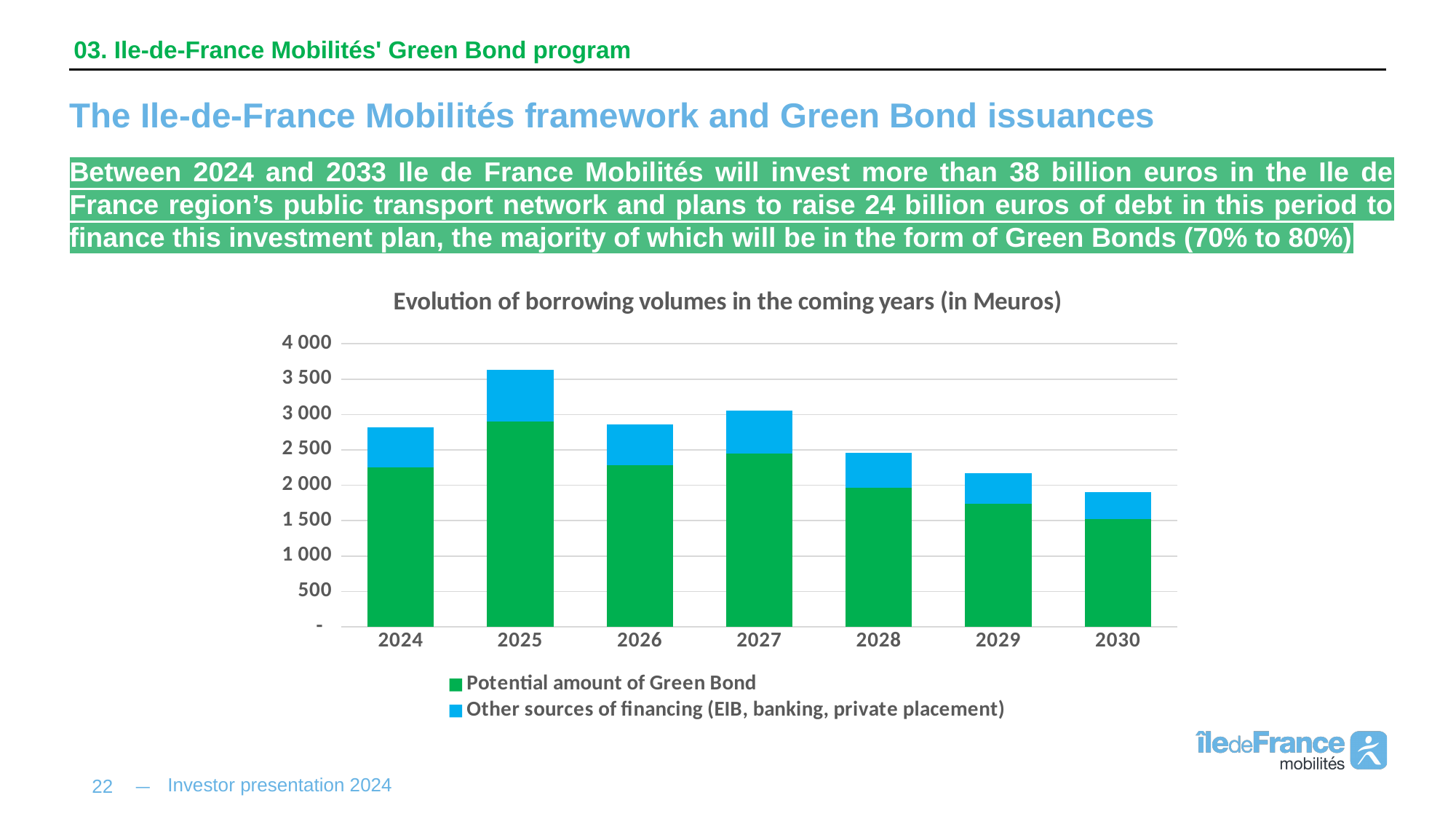
Is the potential amount of Green Bond for 2024 greater or less than 2 000? greater How many years are shown on the x axis of the chart? 7 From 2027 to 2030, do the total borrowing volumes rise or fall? Fall How many series does the chart legend list? 2 Is the total borrowing volume for 2030 greater or less than 2 000? less Which is larger, the potential amount of Green Bond in 2027 or in 2028? 2027 What kind of chart is shown on the slide? Stacked bar chart Which year has the highest total borrowing volume? 2025 What is the title of the chart? Evolution of borrowing volumes in the coming years (in Meuros) Is the potential amount of Green Bond for 2025 greater or less than 2 500? greater Which year has the lowest total borrowing volume? 2030